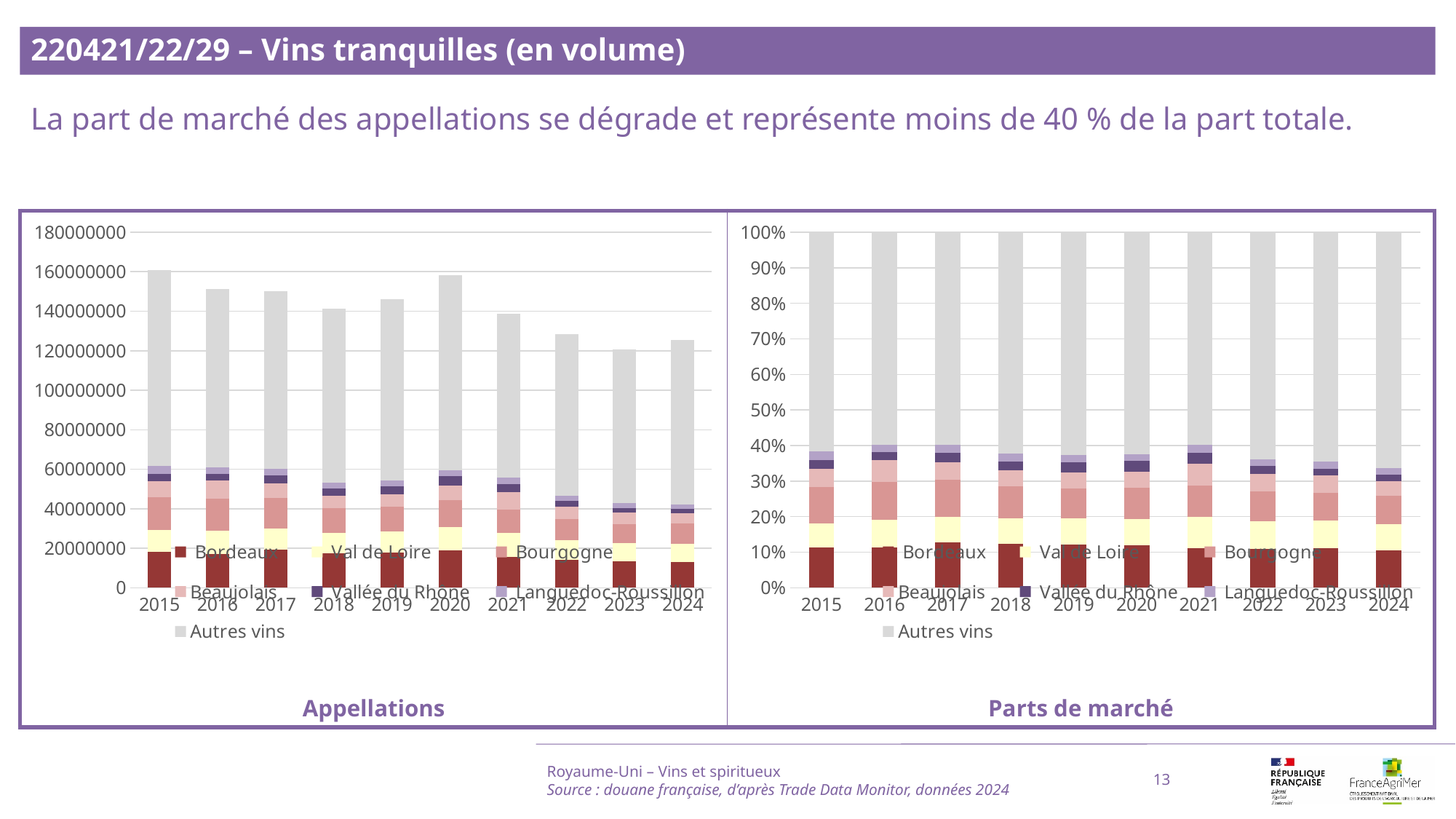
In the 'Parts de marché' chart, what is the total height of each stacked bar? 100% How many years are shown on the x axis of the 'Parts de marché' chart? 10 In the 'Appellations' chart, do the total bars generally rise or fall from 2015 to 2024? fall In the 'Appellations' chart, is the total bar for 2023 greater or less than 140000000? less In the legend of the 'Appellations' chart, which series is shown in grey? Autres vins In the 'Appellations' chart, which year has the larger total bar, 2015 or 2024? 2015 What kind of chart is the 'Appellations' chart on the left? stacked bar chart How many series does the legend of the 'Appellations' chart list? 7 In the 'Appellations' chart, is the total bar for 2020 greater or less than 140000000? greater In the 'Appellations' chart, which year has the larger total bar, 2021 or 2022? 2021 In the 'Parts de marché' chart, is the share of 'Autres vins' in 2024 greater or less than 60%? greater What is the title shown under the right-hand chart? Parts de marché